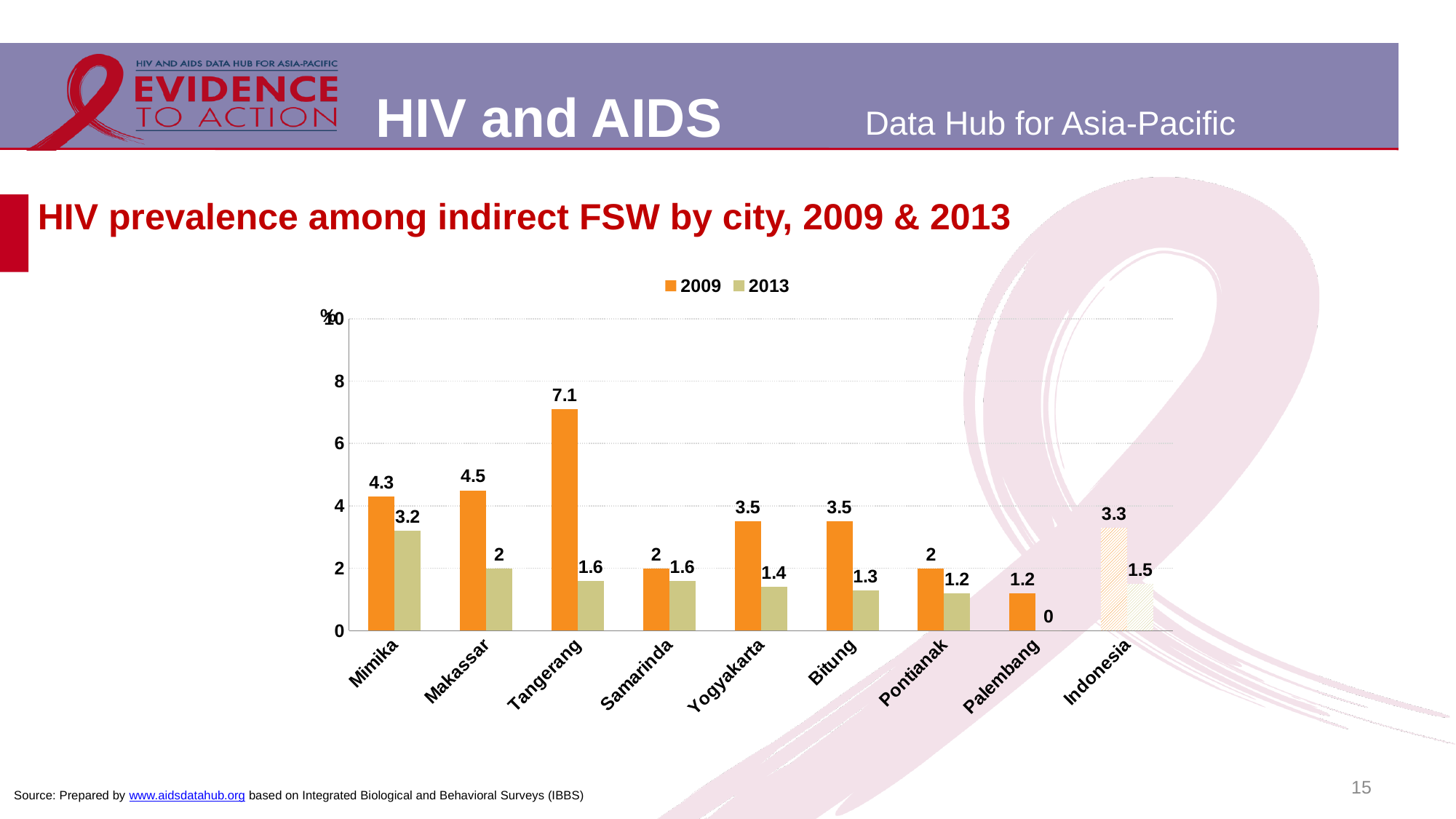
What is the 2013 value for Palembang? 0 What is the 2009 HIV prevalence value for Tangerang? 7.1 Is the 2009 value for Mimika greater or less than 4? greater How many categories are shown on the x axis? 9 How many series does the legend list? 2 Which city has the highest 2009 value? Tangerang What is the title of the chart? HIV prevalence among indirect FSW by city, 2009 & 2013 What is the 2013 HIV prevalence value for Mimika? 3.2 Which category has the lowest 2013 value? Palembang What is the difference between the 2009 and 2013 values for Tangerang? 5.5 What kind of chart is shown on the slide? bar chart Which is larger for Makassar: the 2009 value or the 2013 value? 2009